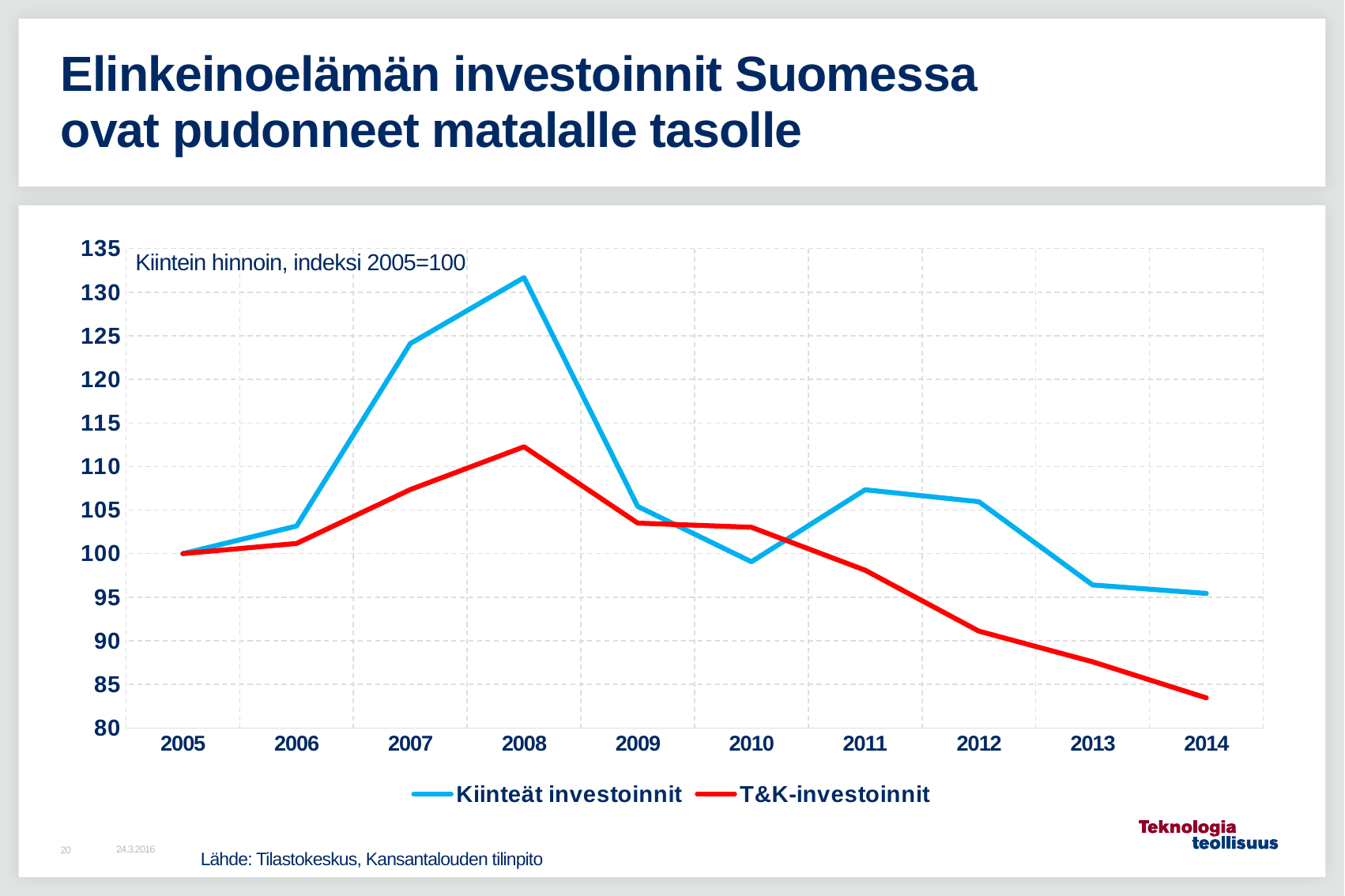
Is the value for T&K-investoinnit in 2014 greater or less than 85? less In which year is T&K-investoinnit at its lowest? 2014 Is the value for Kiinteät investoinnit in 2008 greater or less than 130? greater How many years are plotted along the x axis? 10 What is the value of Kiinteät investoinnit in 2005? 100 What kind of chart is shown on the slide? line chart In which year does Kiinteät investoinnit reach its highest value? 2008 In which year does T&K-investoinnit reach its highest value? 2008 Which series has the higher value in 2011, Kiinteät investoinnit or T&K-investoinnit? Kiinteät investoinnit Does T&K-investoinnit rise or fall from 2008 to 2014? fall How many series does the legend list? 2 Is the value for Kiinteät investoinnit in 2010 greater or less than 100? less